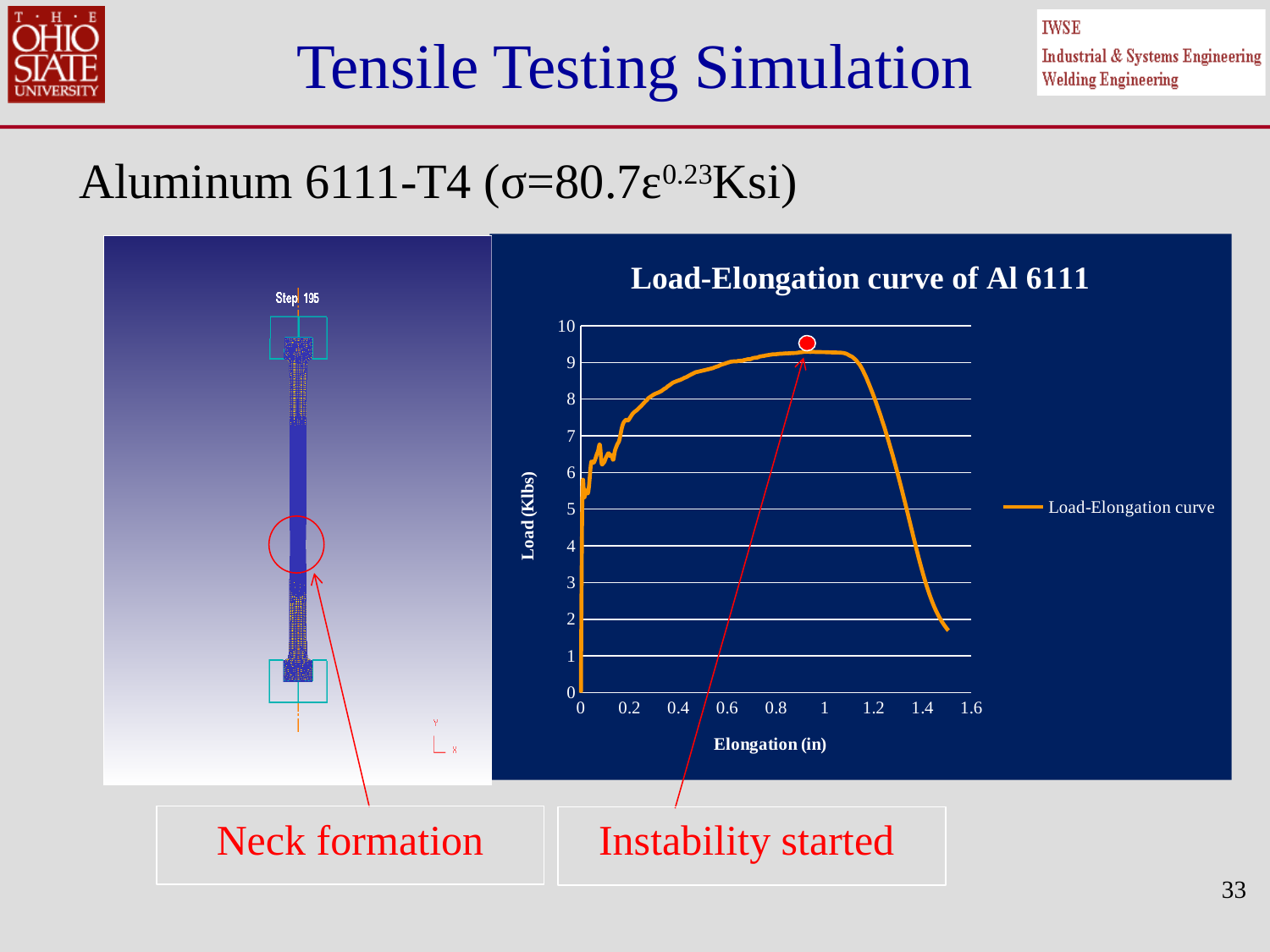
What is the title of the chart on the slide? Load-Elongation curve of Al 6111 Is the load at an elongation of 0.2 in greater or less than 6 Klbs? greater Which is larger, the load at an elongation of 0.8 in or the load at an elongation of 1.4 in? 0.8 in Is the load at an elongation of 0.6 in greater or less than 8 Klbs? greater How many series does the legend of the Load-Elongation chart list? 1 Is the peak load on the curve greater or less than 10 Klbs? less Does the load rise or fall as elongation increases from 1.2 in to 1.4 in? fall Does the load rise or fall as elongation increases from 0.2 in to 0.8 in? rise What kind of chart is shown on the slide? line chart What is the label of the y axis of the chart? Load (Klbs)